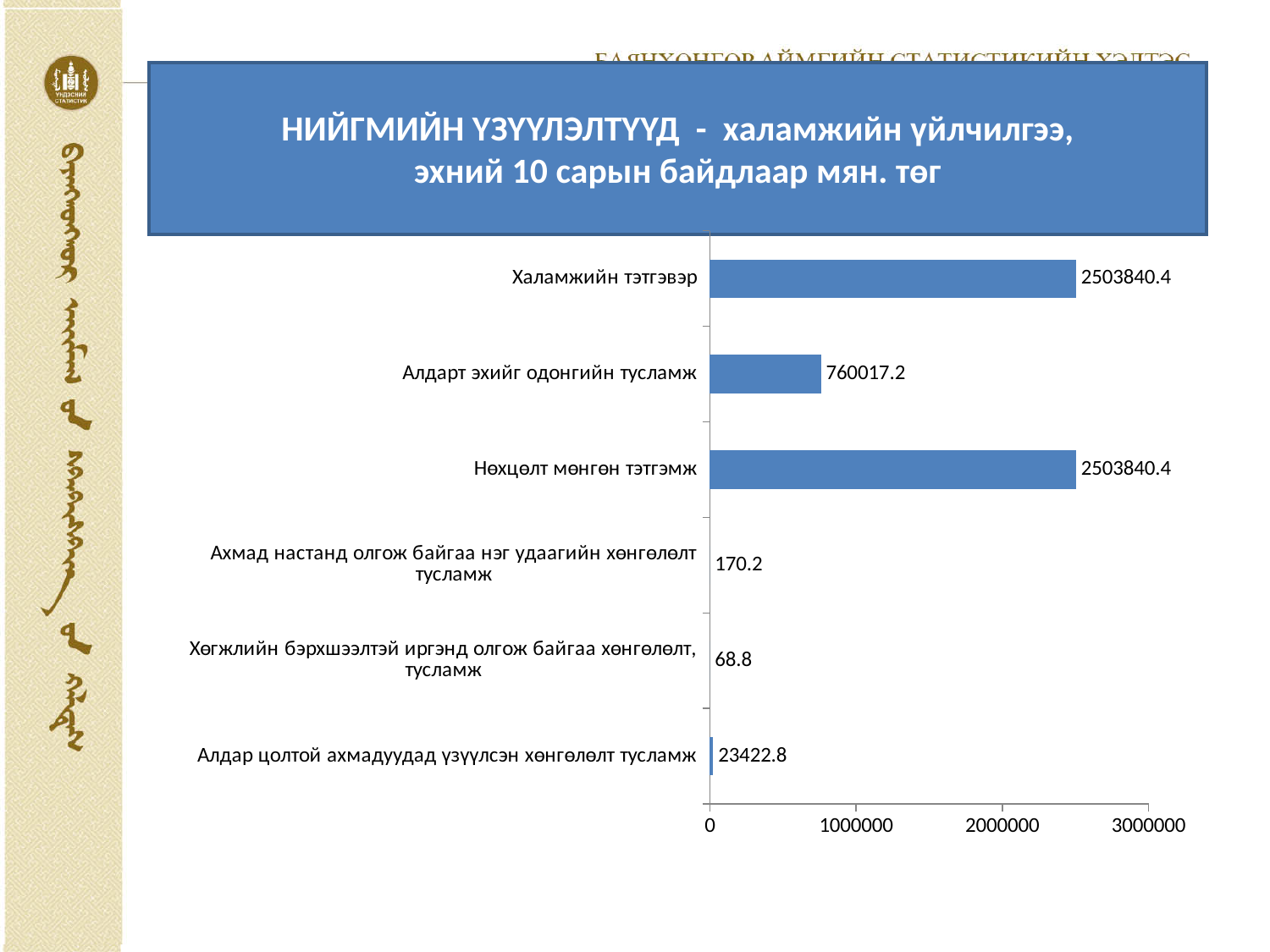
What is the value for Алдарт эхийг одонгийн тусламж? 760017.2 Is the value for Алдарт эхийг одонгийн тусламж greater or less than 1000000? less Which category has the lowest value? Хөгжлийн бэрхшээлтэй иргэнд олгож байгаа хөнгөлөлт, тусламж What is the value for Халамжийн тэтгэвэр? 2503840.4 What is the value for Нөхцөлт мөнгөн тэтгэмж? 2503840.4 What kind of chart is shown on the slide? bar chart What is the value for Ахмад настанд олгож байгаа нэг удаагийн хөнгөлөлт тусламж? 170.2 What is the difference between the values for Халамжийн тэтгэвэр and Алдарт эхийг одонгийн тусламж? 1743823.2 What is the value for Алдар цолтой ахмадуудад үзүүлсэн хөнгөлөлт тусламж? 23422.8 How many categories are shown in the chart? 6 What is the title of the chart? НИЙГМИЙН ҮЗҮҮЛЭЛТҮҮД - халамжийн үйлчилгээ, эхний 10 сарын байдлаар мян. төг Which is larger, the value for Алдарт эхийг одонгийн тусламж or the value for Алдар цолтой ахмадуудад үзүүлсэн хөнгөлөлт тусламж? Алдарт эхийг одонгийн тусламж